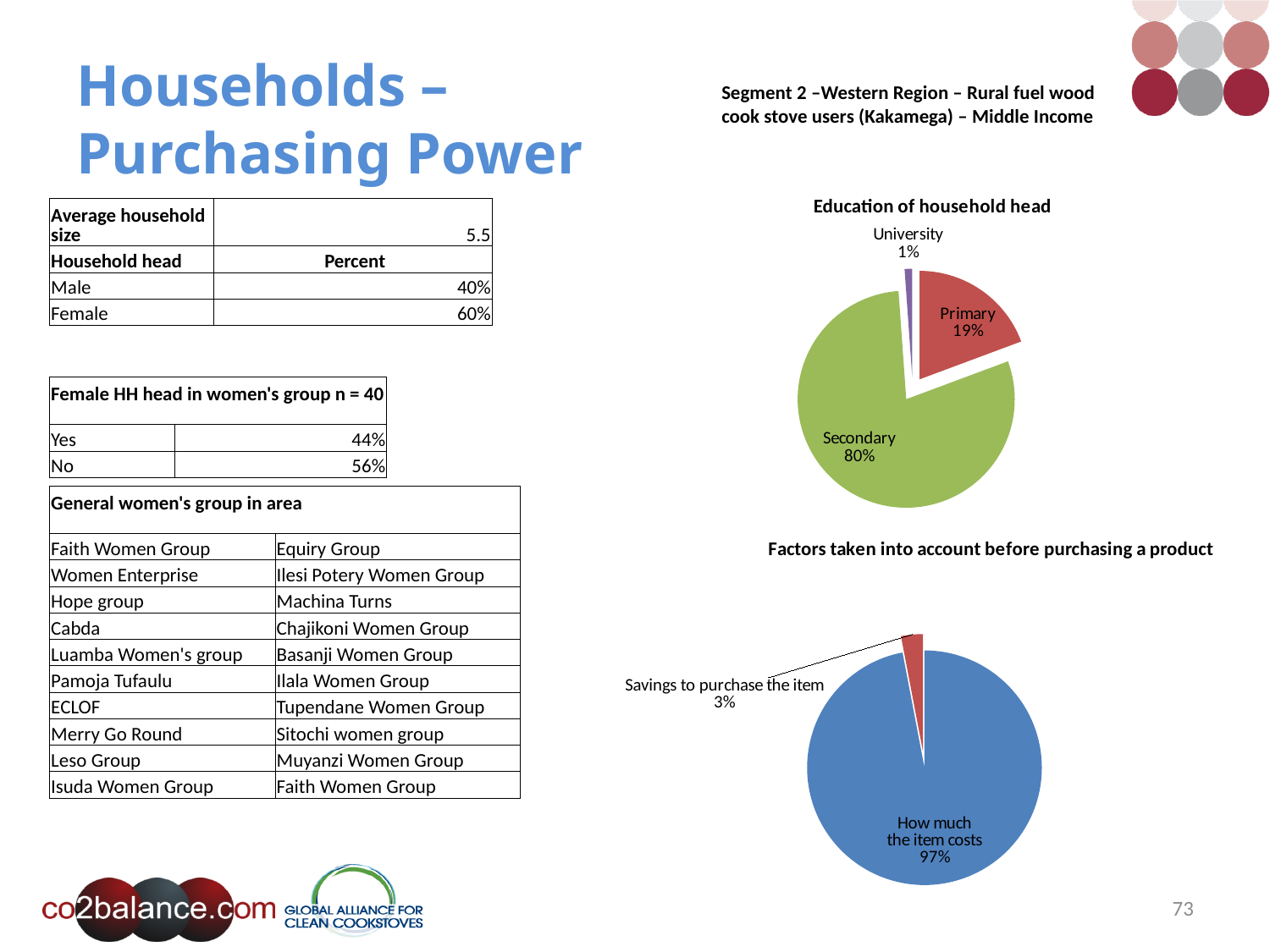
In the 'Education of household head' chart, what percentage of household heads have secondary education? 80% In the 'Factors taken into account before purchasing a product' chart, what share is 'How much the item costs'? 97% In the 'Factors taken into account before purchasing a product' chart, which factor is larger: 'How much the item costs' or 'Savings to purchase the item'? How much the item costs In the 'Education of household head' chart, what percentage of household heads have primary education? 19% In the 'Education of household head' chart, what is the difference in percentage points between Secondary and Primary? 61 In the 'Education of household head' chart, how many education categories are shown? 3 In the 'Education of household head' chart, what percentage of household heads have university education? 1% In the 'Education of household head' chart, which education level has the smallest share? University What type of chart is 'Factors taken into account before purchasing a product'? Pie chart In the 'Factors taken into account before purchasing a product' chart, how many factors are shown? 2 In the 'Factors taken into account before purchasing a product' chart, what share is 'Savings to purchase the item'? 3% In the 'Education of household head' chart, which education level has the largest share? Secondary